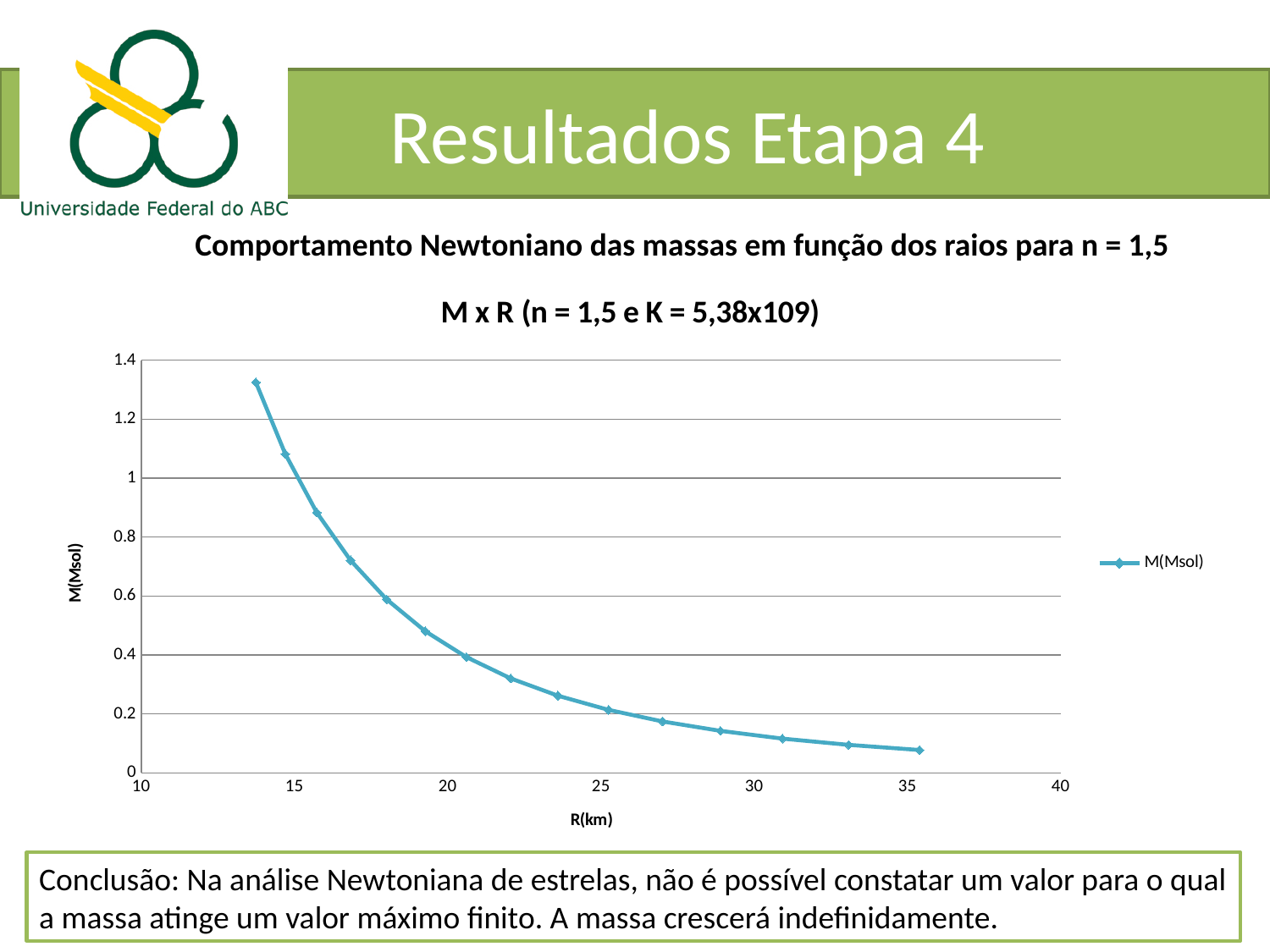
Is the M(Msol) value of the last (rightmost) data point greater or less than 0.2? less How many series does the chart legend list? 1 Is the M(Msol) value at the data point near R = 15 km greater or less than 0.8? greater What is the highest value shown on the y axis of the chart? 1.4 What is the name of the series shown in the chart legend? M(Msol) What is the title of the chart? M x R (n = 1,5 e K = 5,38x109) Is the M(Msol) value of the first (leftmost) data point greater or less than 1.2? greater How many data points are plotted on the M(Msol) line? 15 As R(km) increases along the x axis, does M(Msol) rise or fall? fall Which has the larger M(Msol) value: the data point near R = 15 km or the data point near R = 30 km? the data point near R = 15 km What kind of chart is shown on the slide? line chart